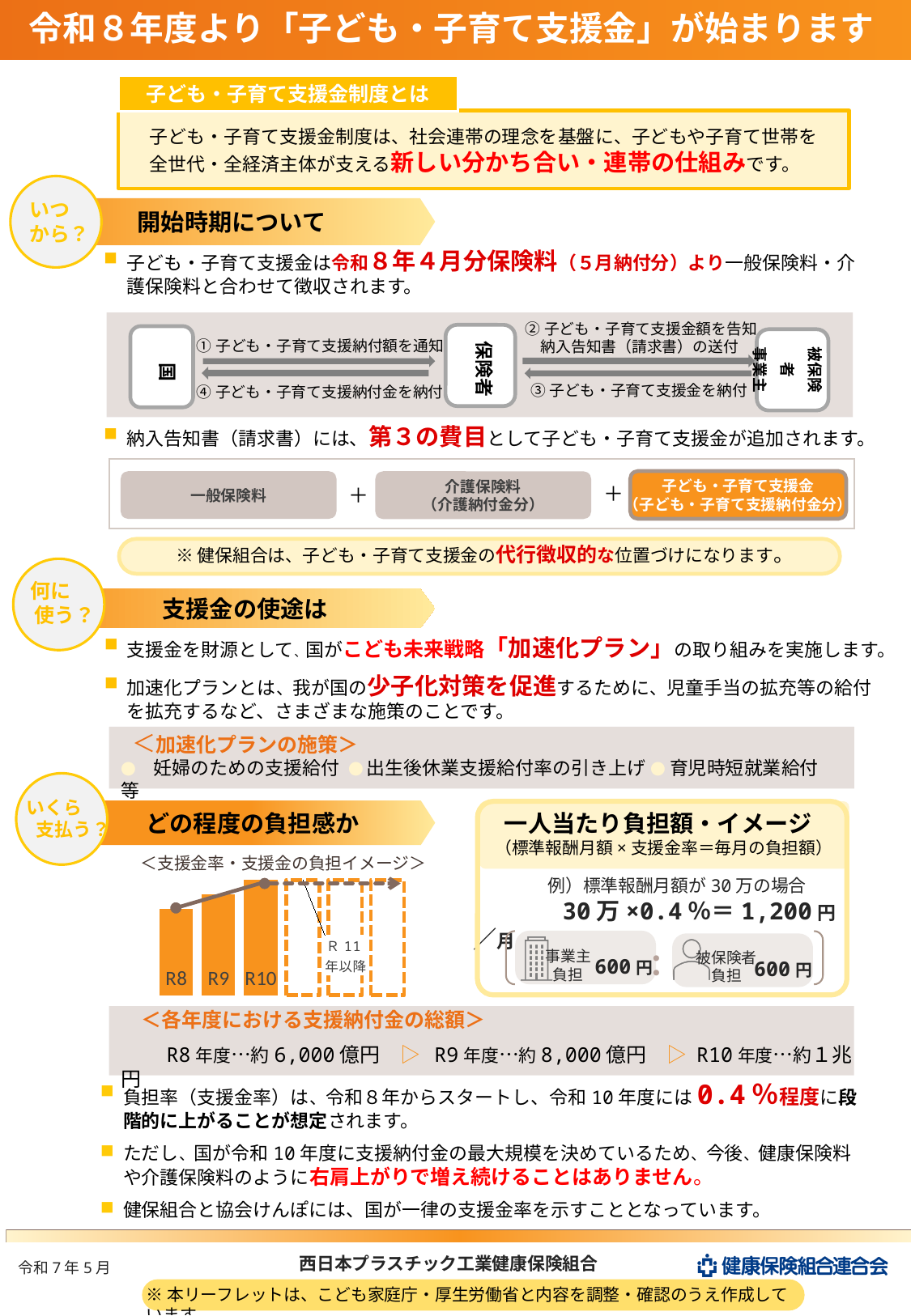
In the ＜支援金率・支援金の負担イメージ＞ chart, how many solid (filled) bars are labelled with a year? 3 In the ＜支援金率・支援金の負担イメージ＞ chart, do the bars rise or fall from R8 to R10? rise In the ＜支援金率・支援金の負担イメージ＞ chart, is the bar for R9 taller or shorter than the bar for R8? taller In the ＜支援金率・支援金の負担イメージ＞ chart, which of the labelled years R8, R9 and R10 has the shortest bar? R8 In the ＜支援金率・支援金の負担イメージ＞ chart, what label is given to the dashed bars after R10? R11年以降 In the ＜支援金率・支援金の負担イメージ＞ chart, which of the labelled years R8, R9 and R10 has the tallest bar? R10 What is the title printed above the bar chart on the slide? ＜支援金率・支援金の負担イメージ＞ What kind of chart is shown under the heading ＜支援金率・支援金の負担イメージ＞? bar chart